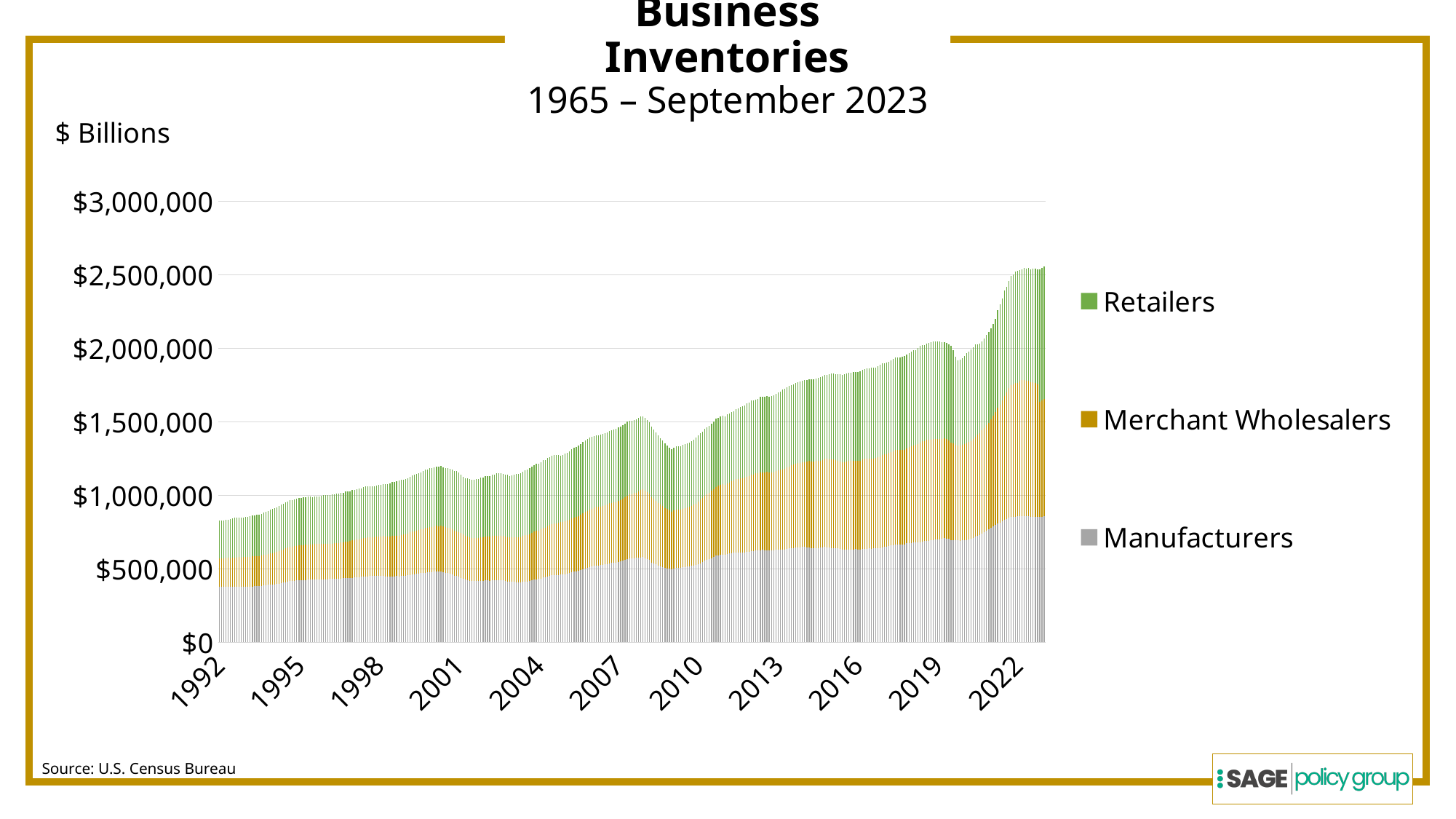
Which year has the larger total business inventories, 1992 or 2022? 2022 Do total business inventories generally rise or fall from 1992 to 2022? Rise What are the three series listed in the legend? Retailers, Merchant Wholesalers, Manufacturers Is the total stacked value in 1992 greater or less than $1,000,000? less What is the title of the chart? Business Inventories Which year has the larger total business inventories, 2010 or 2013? 2013 Is the Manufacturers value in 1992 greater or less than $500,000? less Is the Manufacturers value in 2022 greater or less than $500,000? greater How many series does the legend list? 3 What kind of chart is shown on the slide? Stacked bar chart